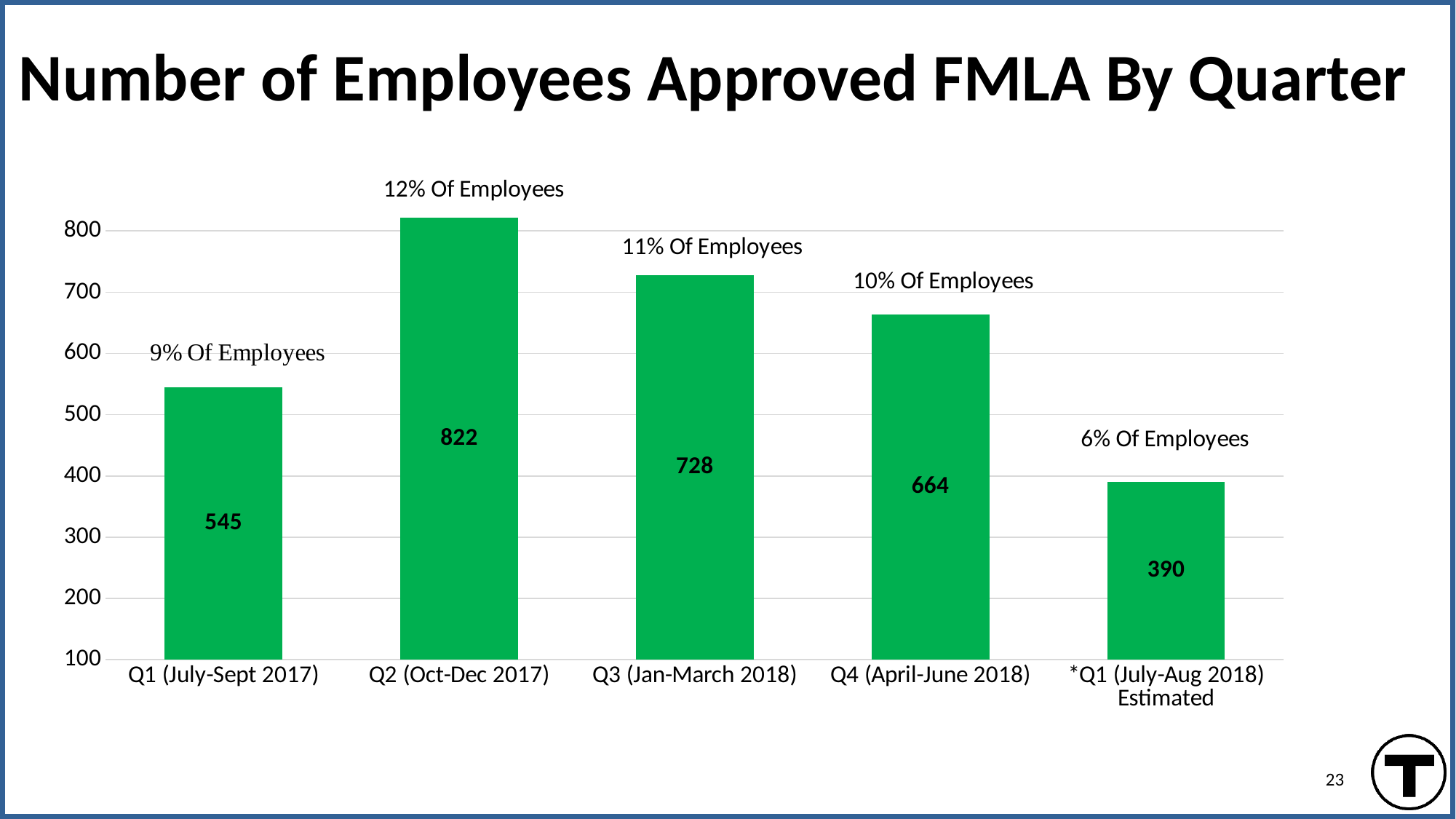
Is the value for Q4 (April-June 2018) greater or less than 600? greater What is the estimated number of employees approved FMLA for *Q1 (July-Aug 2018)? 390 What kind of chart is shown on the slide? Bar chart How many quarters are shown on the chart? 5 Which quarter has more employees approved FMLA, Q3 (Jan-March 2018) or Q4 (April-June 2018)? Q3 (Jan-March 2018) What is the difference between the number of employees approved FMLA in Q2 (Oct-Dec 2017) and Q1 (July-Sept 2017)? 277 What is the title of the chart? Number of Employees Approved FMLA By Quarter What percentage of employees does the Q3 (Jan-March 2018) bar represent? 11% Of Employees Which quarter has the lowest number of employees approved FMLA? *Q1 (July-Aug 2018) Estimated Do the values rise or fall from Q2 (Oct-Dec 2017) to *Q1 (July-Aug 2018) Estimated? Fall How many employees were approved FMLA in Q2 (Oct-Dec 2017)? 822 Which quarter has the highest number of employees approved FMLA? Q2 (Oct-Dec 2017)